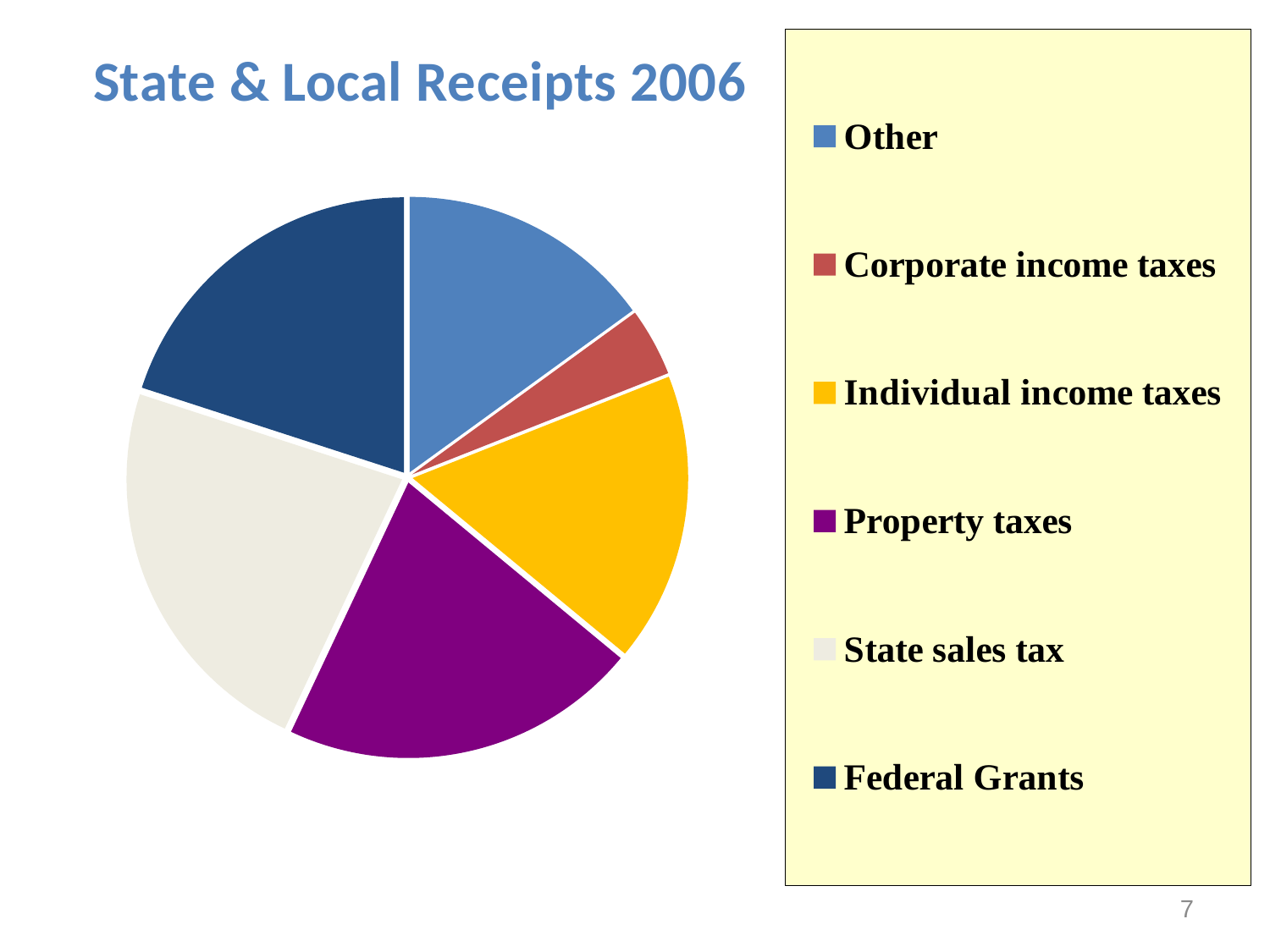
Which slice is larger, Corporate income taxes or Individual income taxes? Individual income taxes What colour is the Property taxes slice? purple How many entries does the legend list? 6 Which slice is larger, State sales tax or Other? State sales tax What is the title of the chart? State & Local Receipts 2006 Which slice is larger, Other or Corporate income taxes? Other What kind of chart is shown on the slide? pie chart How many slices does the pie chart have? 6 Which category has the smallest slice of the pie? Corporate income taxes